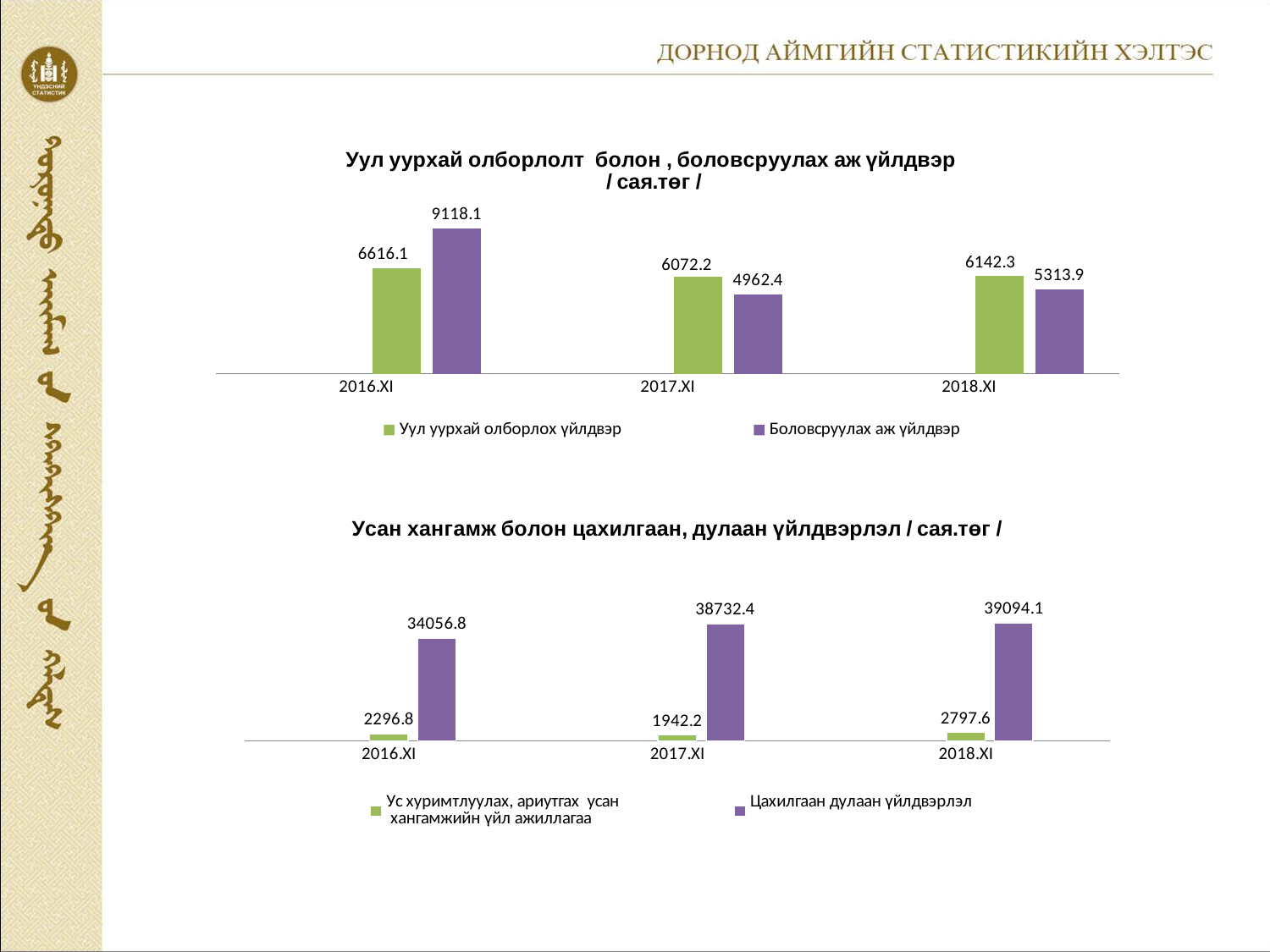
In the top chart, what is the value for Уул уурхай олборлох үйлдвэр in 2017.XI? 6072.2 In the top chart, which period has the lowest value for Уул уурхай олборлох үйлдвэр? 2017.XI In the bottom chart, does the value for Цахилгаан дулаан үйлдвэрлэл rise or fall from 2016.XI to 2018.XI? rise In the top chart, what is the difference between Уул уурхай олборлох үйлдвэр and Боловсруулах аж үйлдвэр in 2018.XI? 828.4 How many periods are shown on the x axis of the bottom chart? 3 In the top chart, what is the value for Боловсруулах аж үйлдвэр in 2016.XI? 9118.1 In the top chart, which period has the highest value for Боловсруулах аж үйлдвэр? 2016.XI In the bottom chart, what is the value for Ус хуримтлуулах, ариутгах усан хангамжийн үйл ажиллагаа in 2017.XI? 1942.2 In the bottom chart, which period has the highest value for Ус хуримтлуулах, ариутгах усан хангамжийн үйл ажиллагаа? 2018.XI In the bottom chart, what is the value for Цахилгаан дулаан үйлдвэрлэл in 2018.XI? 39094.1 In the top chart, which is larger in 2017.XI: Уул уурхай олборлох үйлдвэр or Боловсруулах аж үйлдвэр? Уул уурхай олборлох үйлдвэр What kind of chart is the top chart? bar chart